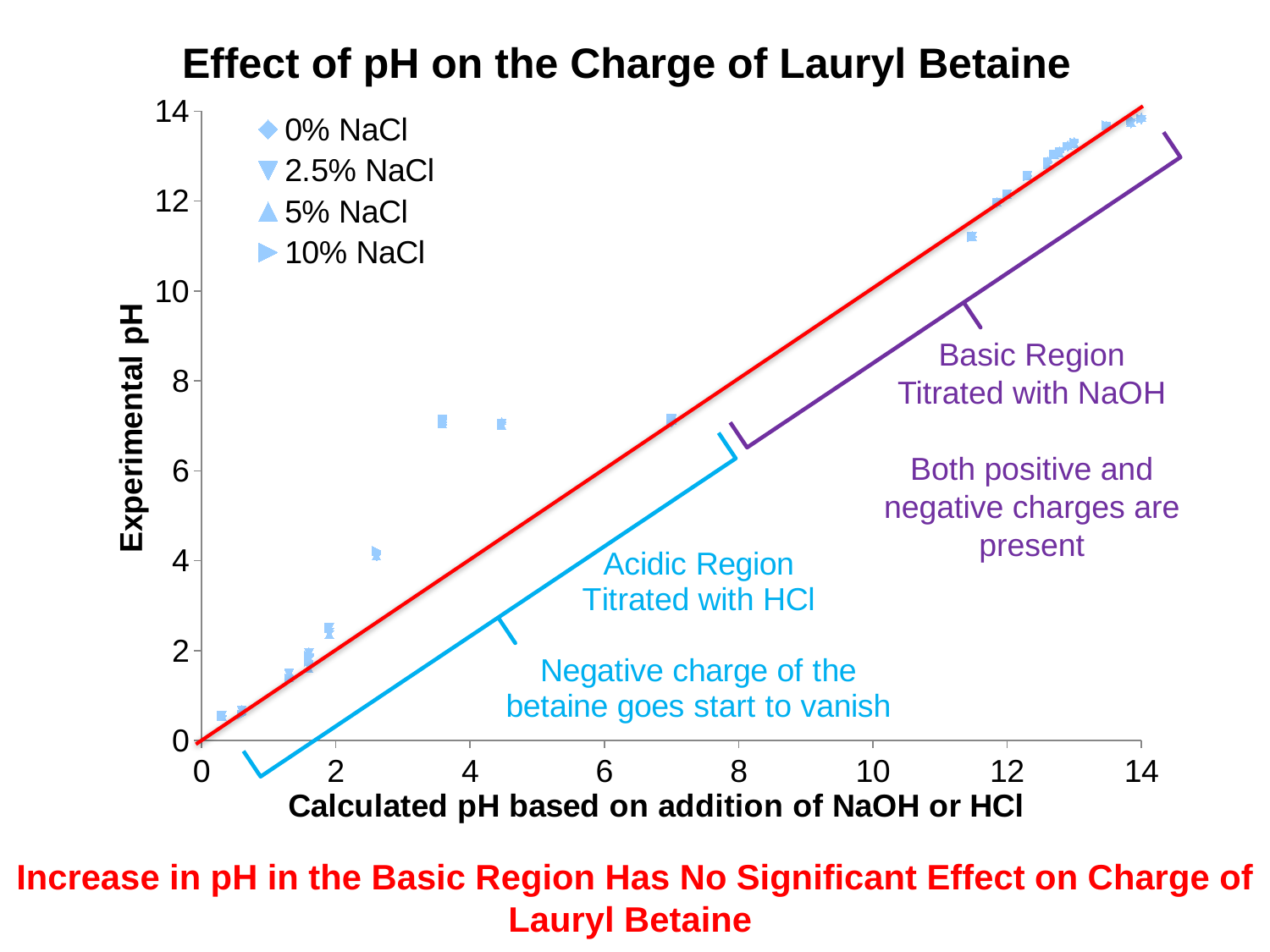
Is the experimental pH of the data point at a calculated pH of about 0.3 greater or less than 2? less Is the experimental pH of the data point at a calculated pH of about 11.5 greater or less than 10? greater Do the experimental pH values rise or fall as the calculated pH increases along the x axis? rise Is the experimental pH of the data point at a calculated pH of about 2.6 greater or less than 6? less What kind of chart is shown on the slide? scatter chart What is the title of the chart? Effect of pH on the Charge of Lauryl Betaine Which has the higher experimental pH: the data point at a calculated pH of about 3.6 or the data point at a calculated pH of about 2.6? the point at about 3.6 What is the label of the y axis? Experimental pH How many series does the legend list? 4